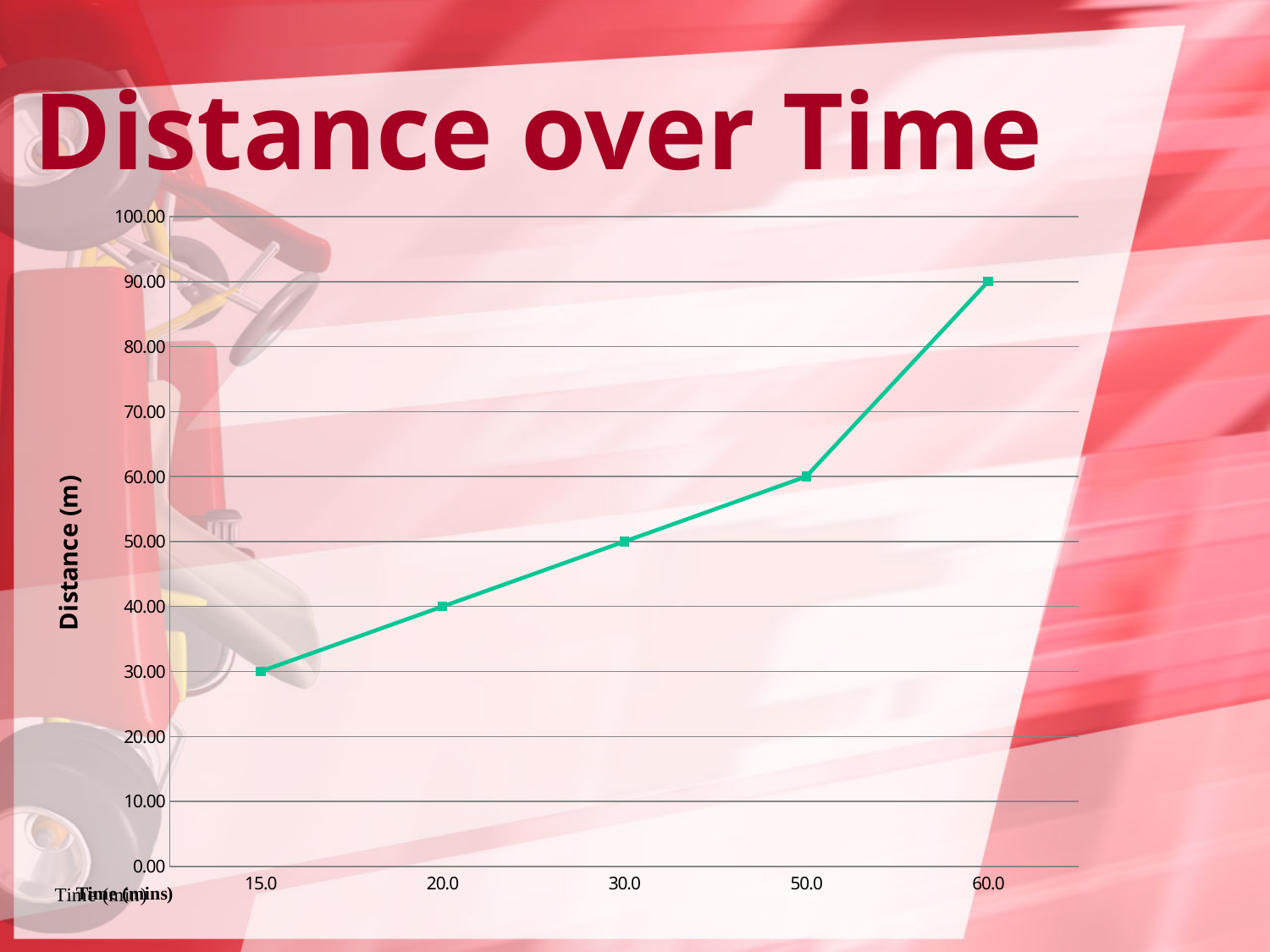
What is the label of the y axis? Distance (m) At which time is the distance highest? 60.0 What is the difference in distance between time 60.0 and time 50.0? 30.00 What is the title shown above the chart? Distance over Time Do the distance values rise or fall as time increases along the x axis? rise Which has a larger distance, time 20.0 or time 50.0? 50.0 What kind of chart is shown on the slide? line chart What is the distance at time 30.0? 50.00 At which time is the distance lowest? 15.0 What is the distance at time 15.0? 30.00 What is the distance at time 60.0? 90.00 How many data points are plotted on the line? 5